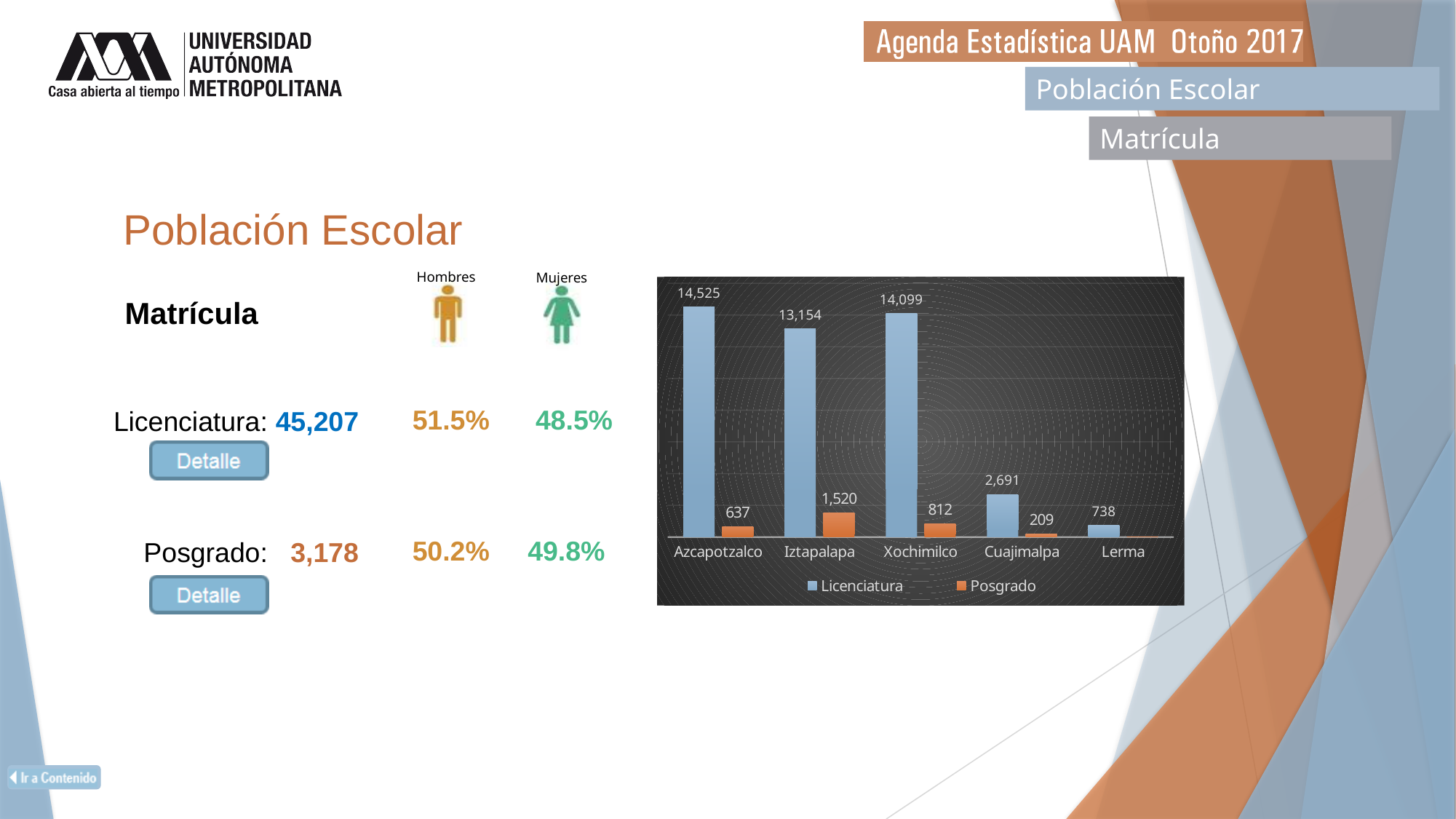
What is the Posgrado value for Iztapalapa? 1,520 How many series does the chart legend list? 2 Which campus has the highest Licenciatura value? Azcapotzalco Which is larger, the Posgrado value for Xochimilco or the Posgrado value for Azcapotzalco? Xochimilco How many campuses are shown on the x axis of the chart? 5 What is the difference between the Licenciatura and Posgrado values for Cuajimalpa? 2,482 What is the Licenciatura value for Azcapotzalco? 14,525 What is the difference between the Licenciatura values for Azcapotzalco and Xochimilco? 426 What is the Licenciatura value for Lerma? 738 Which campus has the lowest Posgrado value among those with a Posgrado label? Cuajimalpa Which colour represents the Posgrado series in the chart? Orange What kind of chart is shown on the slide? Bar chart